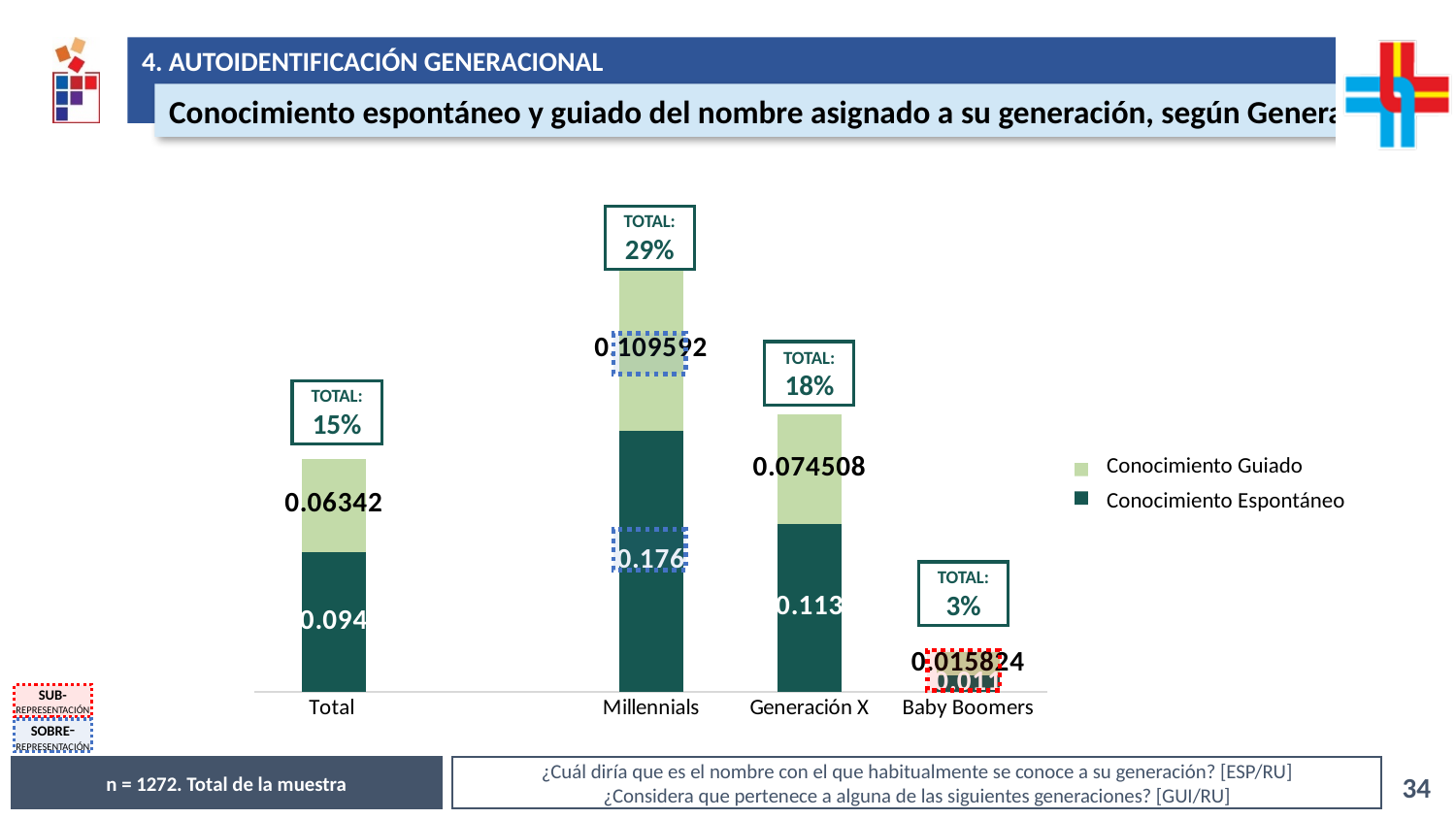
What is the Conocimiento Guiado value for Generación X? 0.074508 Which legend entry is shown in dark green? Conocimiento Espontáneo What is the Conocimiento Guiado value for the Total category? 0.06342 Which is larger, the Conocimiento Espontáneo value for Millennials or for Generación X? Millennials How many series does the legend list? 2 What is the Conocimiento Espontáneo value for Millennials? 0.176 Which category has the lowest TOTAL? Baby Boomers What kind of chart is shown on the slide? stacked bar chart What is the TOTAL shown above the Baby Boomers bar? 3% How many categories are shown on the x axis? 4 Which category has the highest TOTAL? Millennials What is the Conocimiento Espontáneo value for Generación X? 0.113